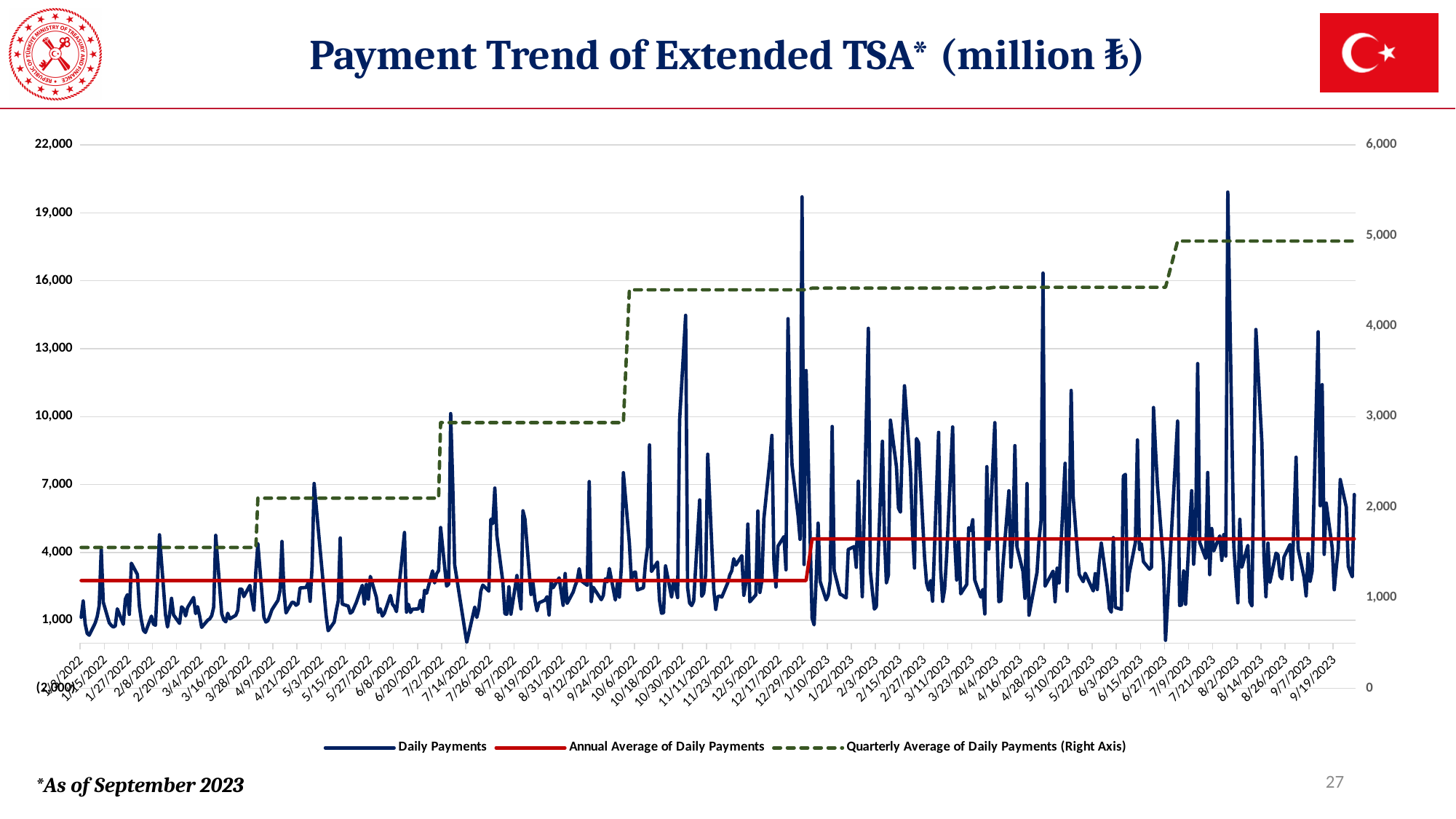
Is the Annual Average of Daily Payments in 2023 greater or less than 4,000? greater What kind of chart is shown on the slide? Line chart On the right axis, is the Quarterly Average of Daily Payments in the last quarter shown greater or less than 4,000? greater Which series is plotted against the right axis according to the legend? Quarterly Average of Daily Payments How many series does the legend list? 3 Is the Quarterly Average of Daily Payments higher in the last quarter shown or in the first quarter shown? Last quarter shown On the right axis, is the Quarterly Average of Daily Payments in the first quarter of 2022 greater or less than 2,000? less Is the Annual Average of Daily Payments higher in 2023 or in 2022? 2023 Does the Quarterly Average of Daily Payments rise or fall over the period shown? Rise What is the title of the chart? Payment Trend of Extended TSA* (million ₺)